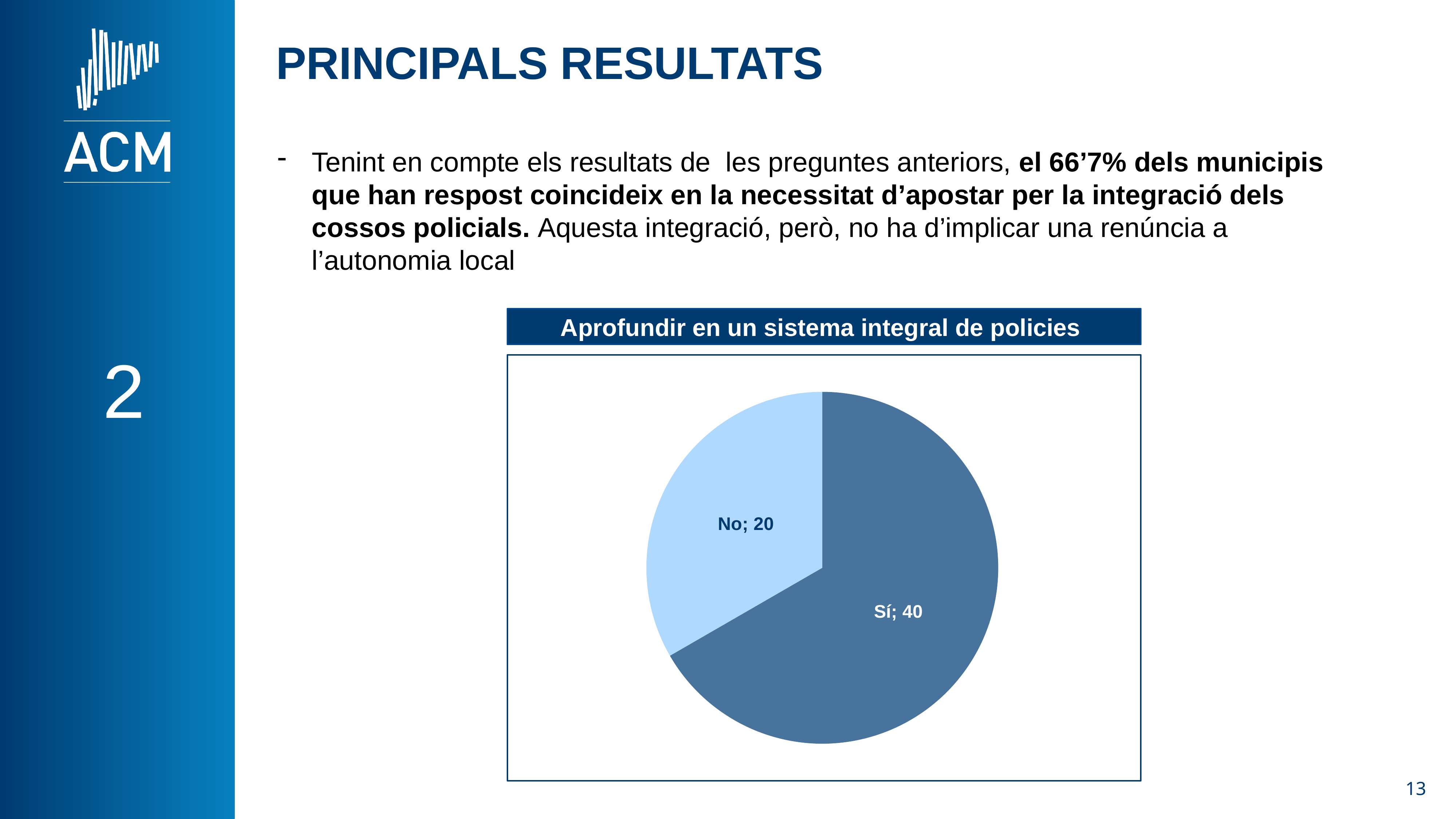
What is the title of the pie chart? Aprofundir en un sistema integral de policies Which is larger in the pie chart, "Sí" or "No"? Sí Which slice of the pie chart is shown in the lighter blue colour? No Which slice of the pie chart is the smallest? No What is the total of all slices in the pie chart? 60 How many slices does the pie chart have? 2 What kind of chart is shown on the slide? Pie chart What is the value for the "No" slice in the pie chart? 20 What share of the pie chart does the "No" slice represent? 33.3% What is the value for the "Sí" slice in the pie chart? 40 Which slice of the pie chart is the largest? Sí What is the difference between the "Sí" and "No" values in the pie chart? 20